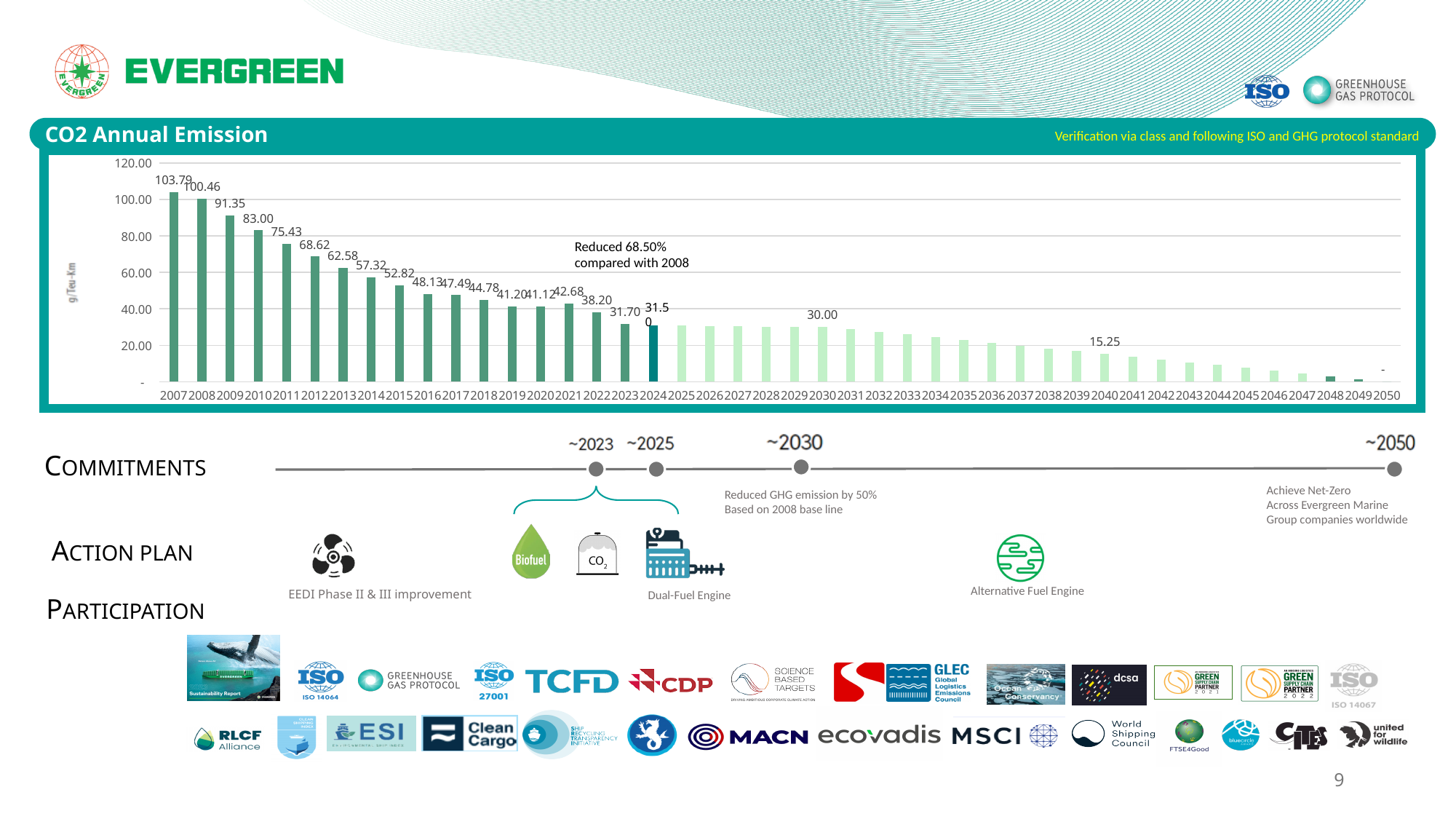
Which year has the larger value, 2021 or 2022? 2021 What is the CO2 annual emission value for 2013? 62.58 What is the CO2 annual emission value for 2007? 103.79 Which year has the highest CO2 annual emission value? 2007 What value is labelled for 2030 on the CO2 Annual Emission chart? 30.00 Do the values generally rise or fall from 2007 to 2050? fall What value is labelled for 2040 on the CO2 Annual Emission chart? 15.25 What is the difference between the 2007 and 2008 values? 3.33 What unit is shown on the y axis of the chart? g/Teu-Km Is the value for 2035 greater or less than 40.00? less What kind of chart is the CO2 Annual Emission chart? bar chart What is the difference between the 2030 and 2040 values? 14.75